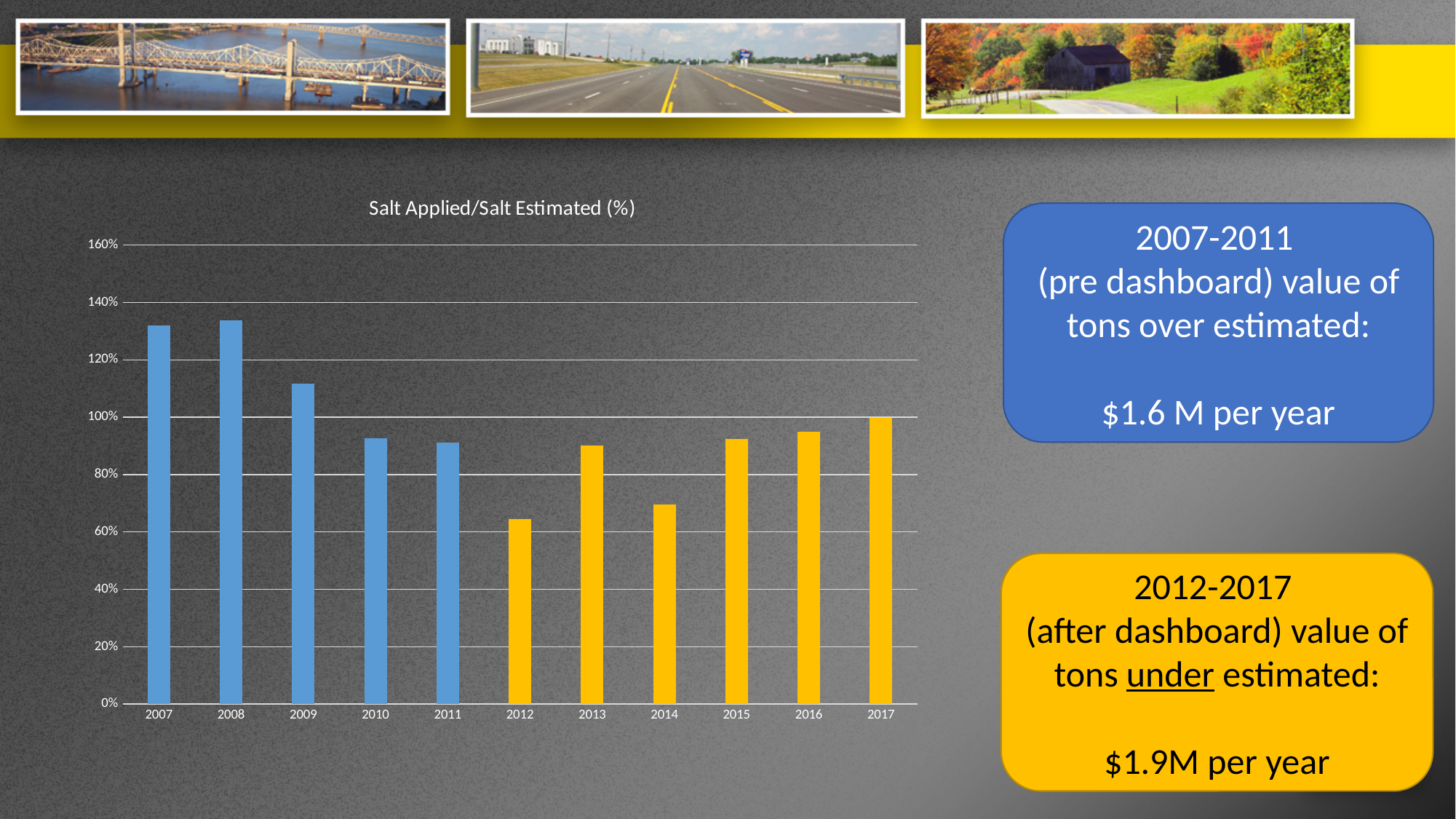
Is the value for 2010 greater or less than 100%? less Which is larger, the value for 2009 or the value for 2010? 2009 Is the value for 2009 greater or less than 100%? greater Do the values rise or fall from 2012 to 2017? rise What colour are the bars for the years 2012 through 2017? yellow What kind of chart is shown on the slide? bar chart Is the value for 2014 greater or less than 60%? greater Which year has the lowest value in the chart? 2012 How many years are plotted on the x axis of the chart? 11 What is the title of the chart? Salt Applied/Salt Estimated (%)